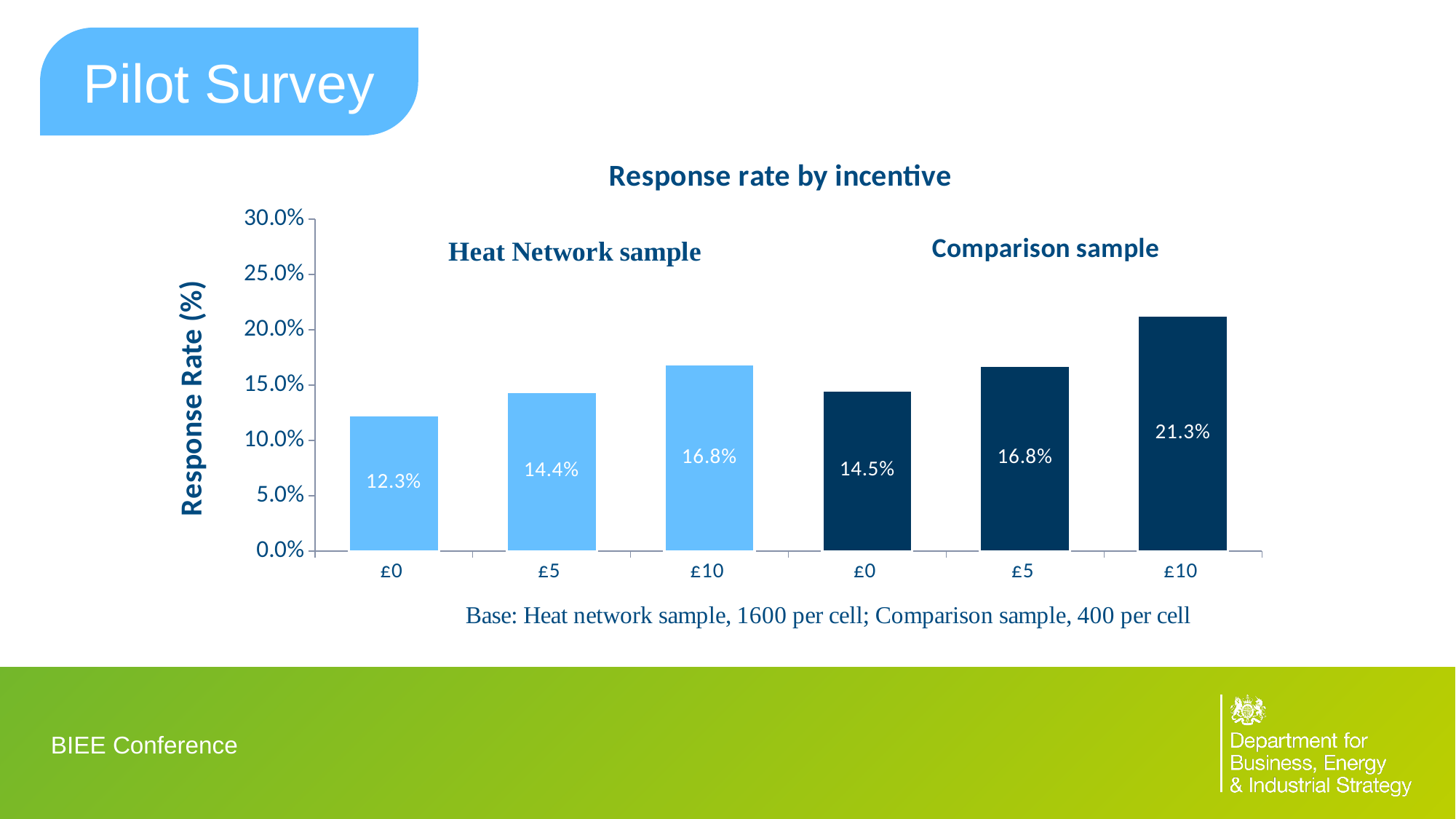
What is the response rate for the £0 incentive in the Heat Network sample? 12.3% What is the difference between the £10 and £0 response rates in the Comparison sample? 6.8% Is the response rate for £10 in the Comparison sample greater or less than 20.0%? greater What is the title of the chart? Response rate by incentive What is the response rate for the £10 incentive in the Comparison sample? 21.3% Which bar has the lowest response rate? £0 in the Heat Network sample What is the difference between the £10 and £0 response rates in the Heat Network sample? 4.5% How many bars are plotted in the chart? 6 Which bar has the highest response rate? £10 in the Comparison sample Which is larger: the £0 response rate in the Heat Network sample or the £0 response rate in the Comparison sample? Comparison sample What kind of chart is shown on the slide? Bar chart What is the response rate for the £5 incentive in the Heat Network sample? 14.4%